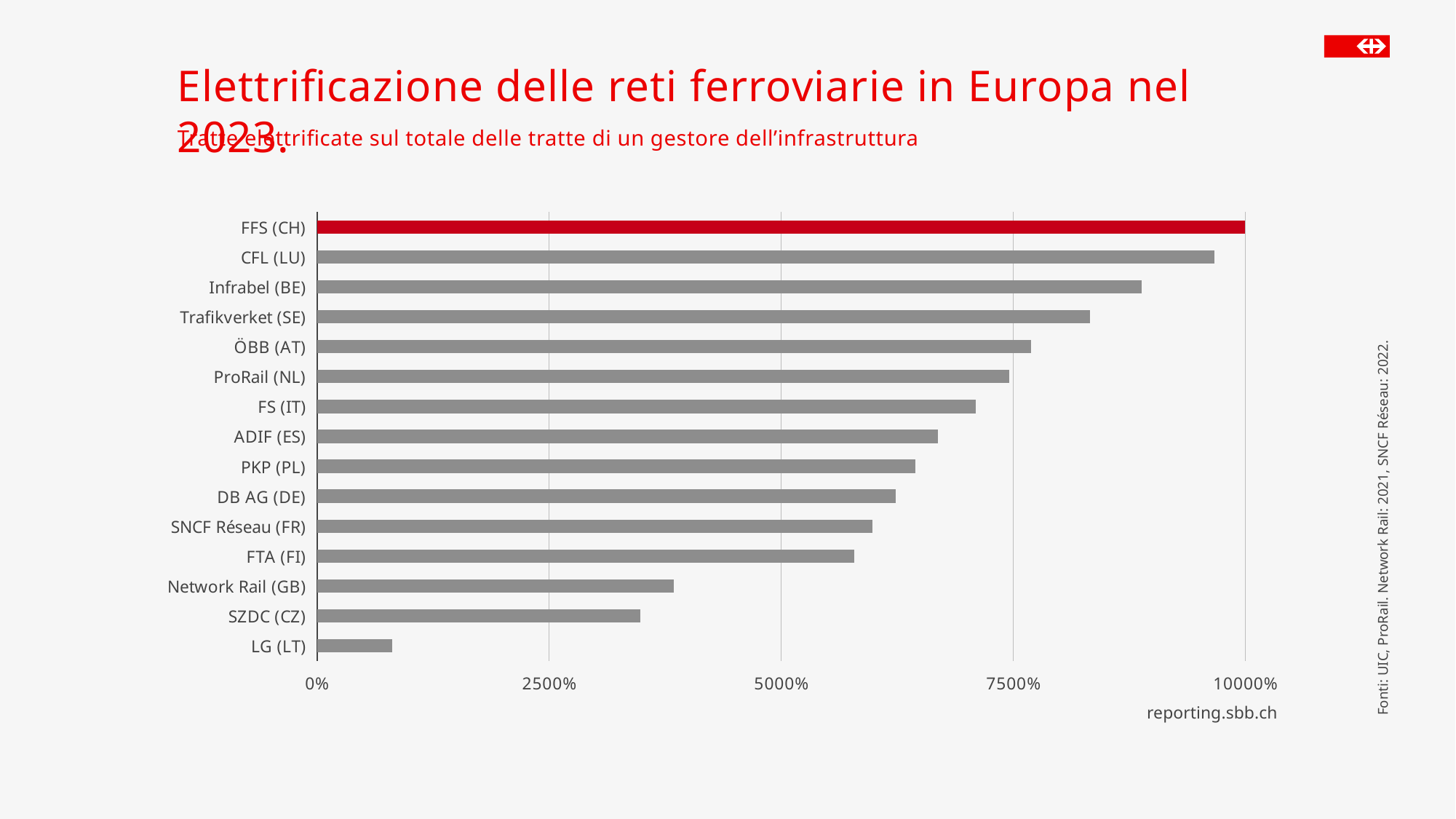
Is the value for LG (LT) greater or less than 2500%? less Which infrastructure manager has the highest value in the chart? FFS (CH) Is the value for CFL (LU) greater or less than 7500%? greater Which infrastructure manager has the lowest value in the chart? LG (LT) Is the value for Network Rail (GB) greater or less than 5000%? less Which has the larger value, Infrabel (BE) or Trafikverket (SE)? Infrabel (BE) Which bar is coloured red instead of grey? FFS (CH) What kind of chart is shown on the slide? bar chart How many infrastructure managers (categories) are shown in the chart? 15 Do the bar values increase or decrease going from the top of the chart to the bottom? decrease